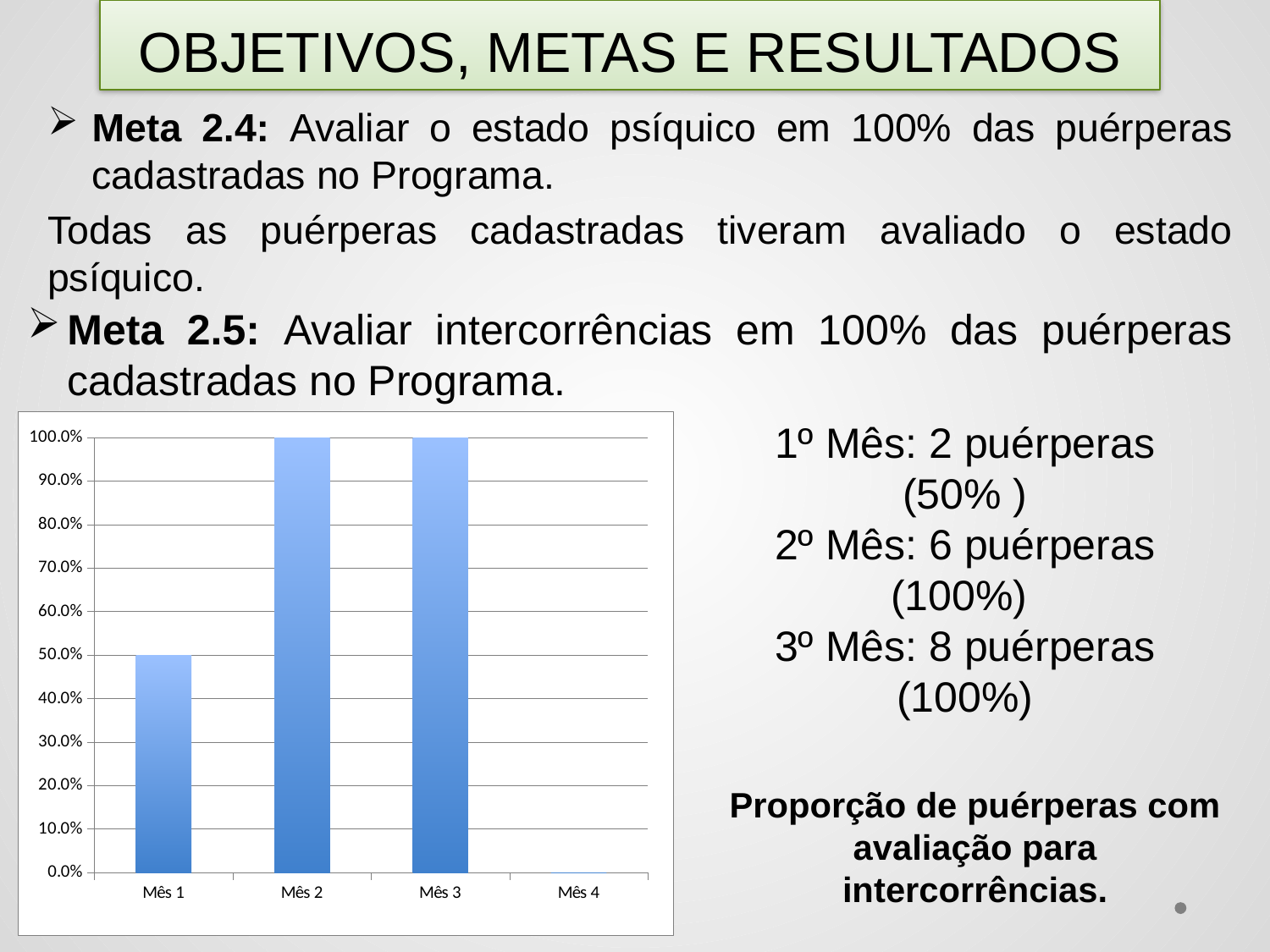
Is the value for Mês 1 greater or less than 60.0%? less What is the difference between the values for Mês 2 and Mês 1? 50.0% What is the value for Mês 1 in the chart? 50.0% Is the value for Mês 3 greater or less than 90.0%? greater What is the value for Mês 3 in the chart? 100.0% How many categories are labelled on the x axis of the chart? 4 Do the values rise or fall from Mês 1 to Mês 2? rise What is the value for Mês 2 in the chart? 100.0% What is the highest value shown on the y axis of the chart? 100.0% What kind of chart is shown on the slide? bar chart Of Mês 1, Mês 2 and Mês 3, which has the lowest value? Mês 1 Which is larger, the value for Mês 1 or the value for Mês 2? Mês 2